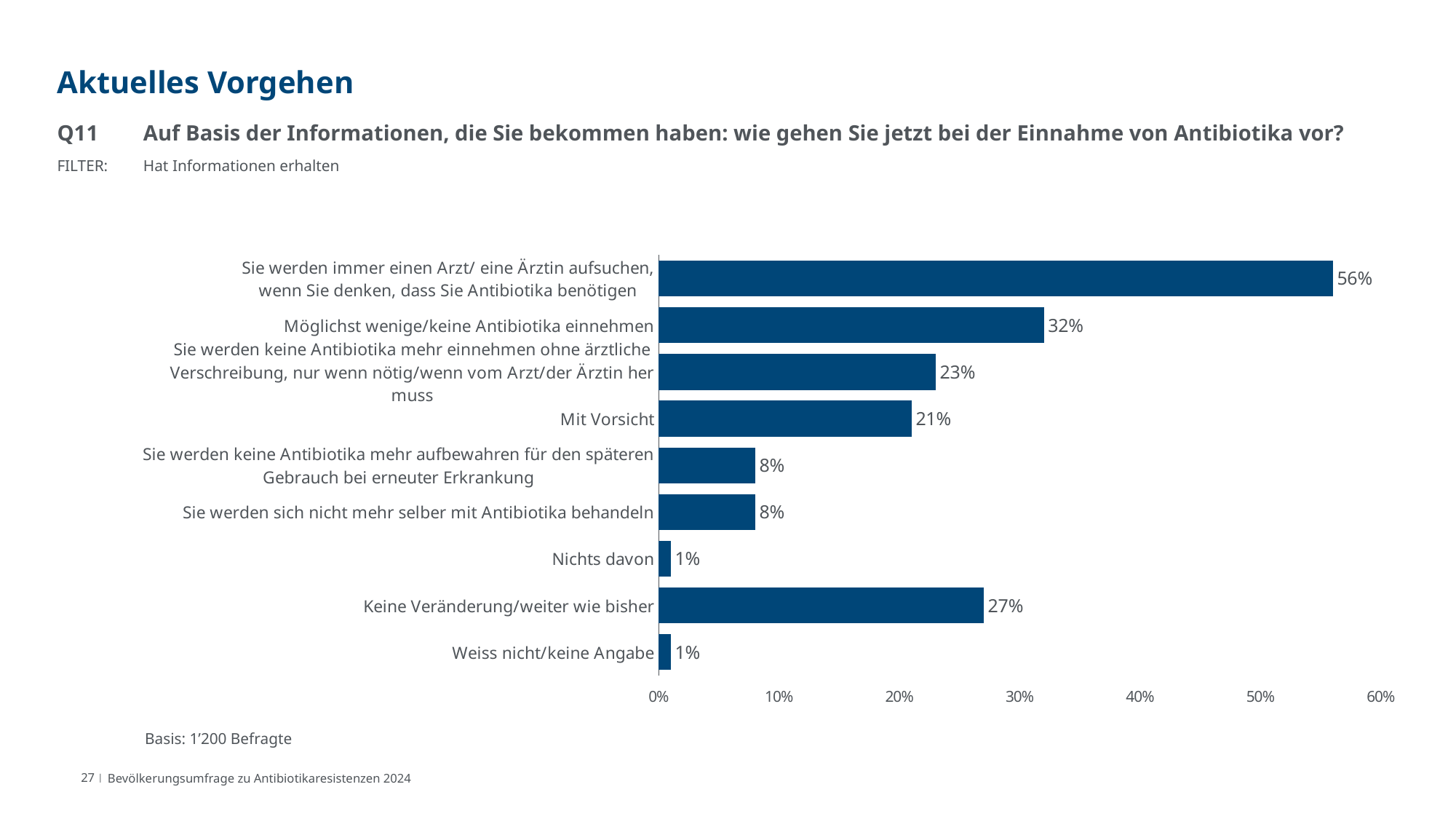
What is the value for "Mit Vorsicht"? 21% What kind of chart is shown on the slide? bar chart What is the value for "Keine Veränderung/weiter wie bisher"? 27% What is the difference between the highest value and the value for "Mit Vorsicht"? 35% Which category has the highest value? Sie werden immer einen Arzt/ eine Ärztin aufsuchen, wenn Sie denken, dass Sie Antibiotika benötigen What is the highest value shown on the x axis? 60% How many categories are shown in the chart? 9 Is the value for "Sie werden keine Antibiotika mehr einnehmen ohne ärztliche Verschreibung, nur wenn nötig/wenn vom Arzt/der Ärztin her muss" greater or less than 20%? greater What is the difference between the values for "Möglichst wenige/keine Antibiotika einnehmen" and "Keine Veränderung/weiter wie bisher"? 5% Which is larger: the value for "Mit Vorsicht" or the value for "Keine Veränderung/weiter wie bisher"? Keine Veränderung/weiter wie bisher What is the value for "Sie werden sich nicht mehr selber mit Antibiotika behandeln"? 8% What is the value for "Möglichst wenige/keine Antibiotika einnehmen"? 32%